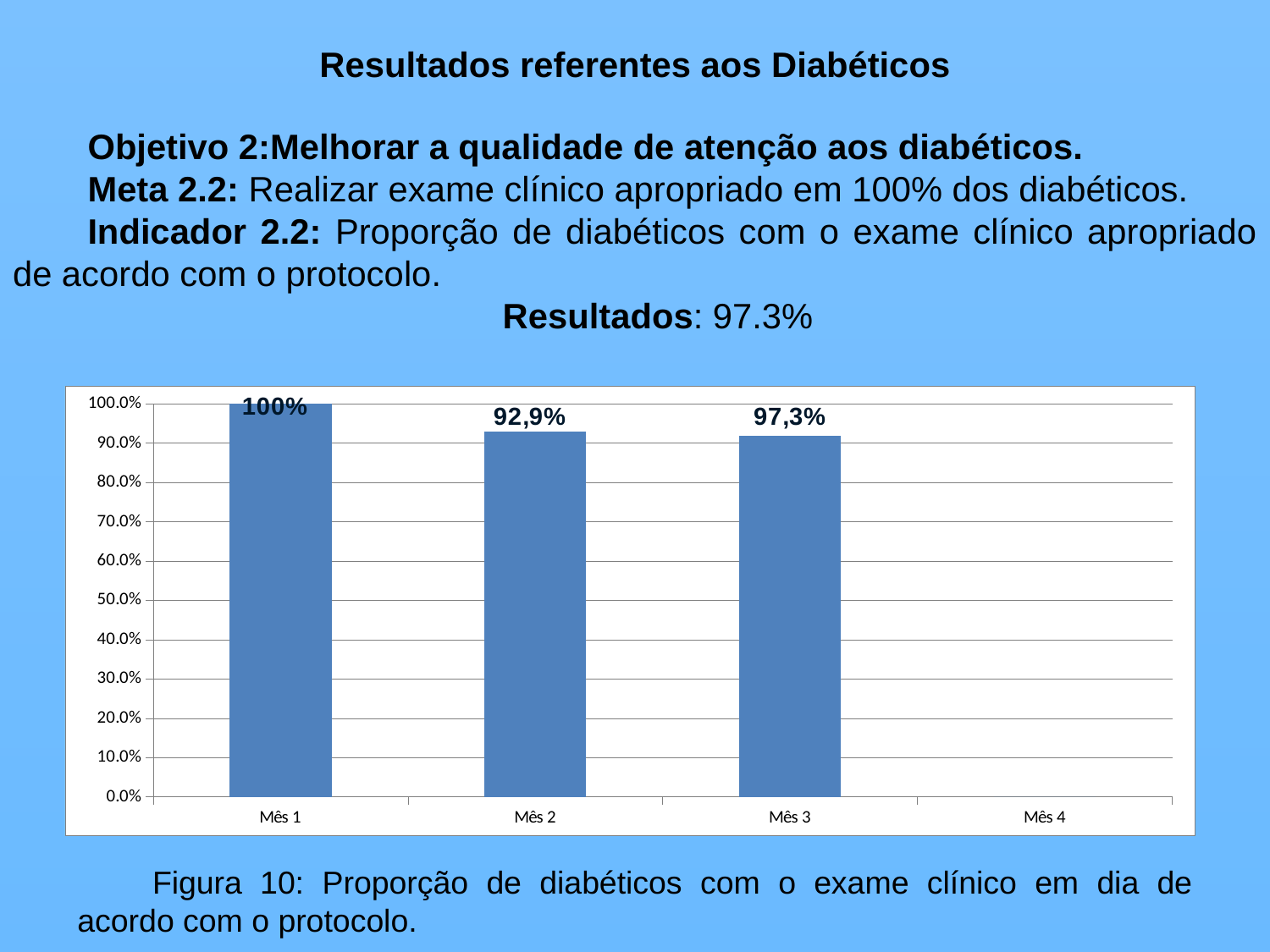
Which month has the highest value? Mês 1 Is the value for Mês 2 greater or less than 90.0%? greater What is the value for Mês 2? 92,9% Which month on the x axis has no bar plotted? Mês 4 What is the value for Mês 1? 100% What is the value for Mês 3? 97,3% What kind of chart is shown on the slide? bar chart What is the difference between the values for Mês 1 and Mês 2? 7,1% How many categories are shown on the x axis? 4